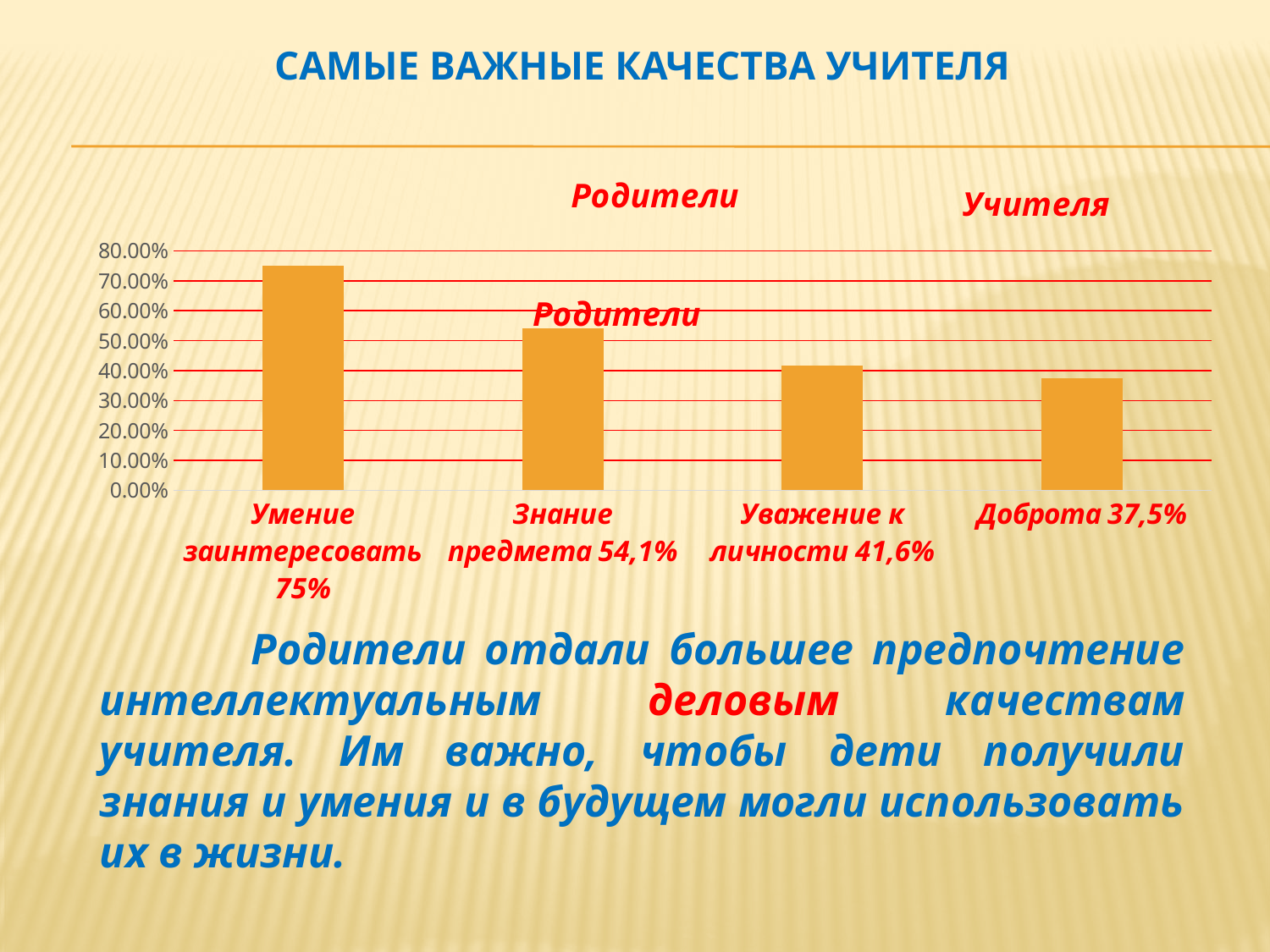
What is the difference between the values for "Умение заинтересовать" and "Знание предмета"? 20,9% Which is larger: the value for "Знание предмета" or the value for "Уважение к личности"? Знание предмета Which category has the lowest value? Доброта Do the bar values rise or fall from left to right along the x axis? fall What is the difference between the values for "Умение заинтересовать" and "Доброта"? 37,5% What is the value for "Умение заинтересовать"? 75% Which category has the highest value? Умение заинтересовать What is the value for "Знание предмета"? 54,1% What is the value for "Уважение к личности"? 41,6% How many categories (bars) does the chart show? 4 What type of chart is shown on the slide? bar chart What is the value for "Доброта"? 37,5%